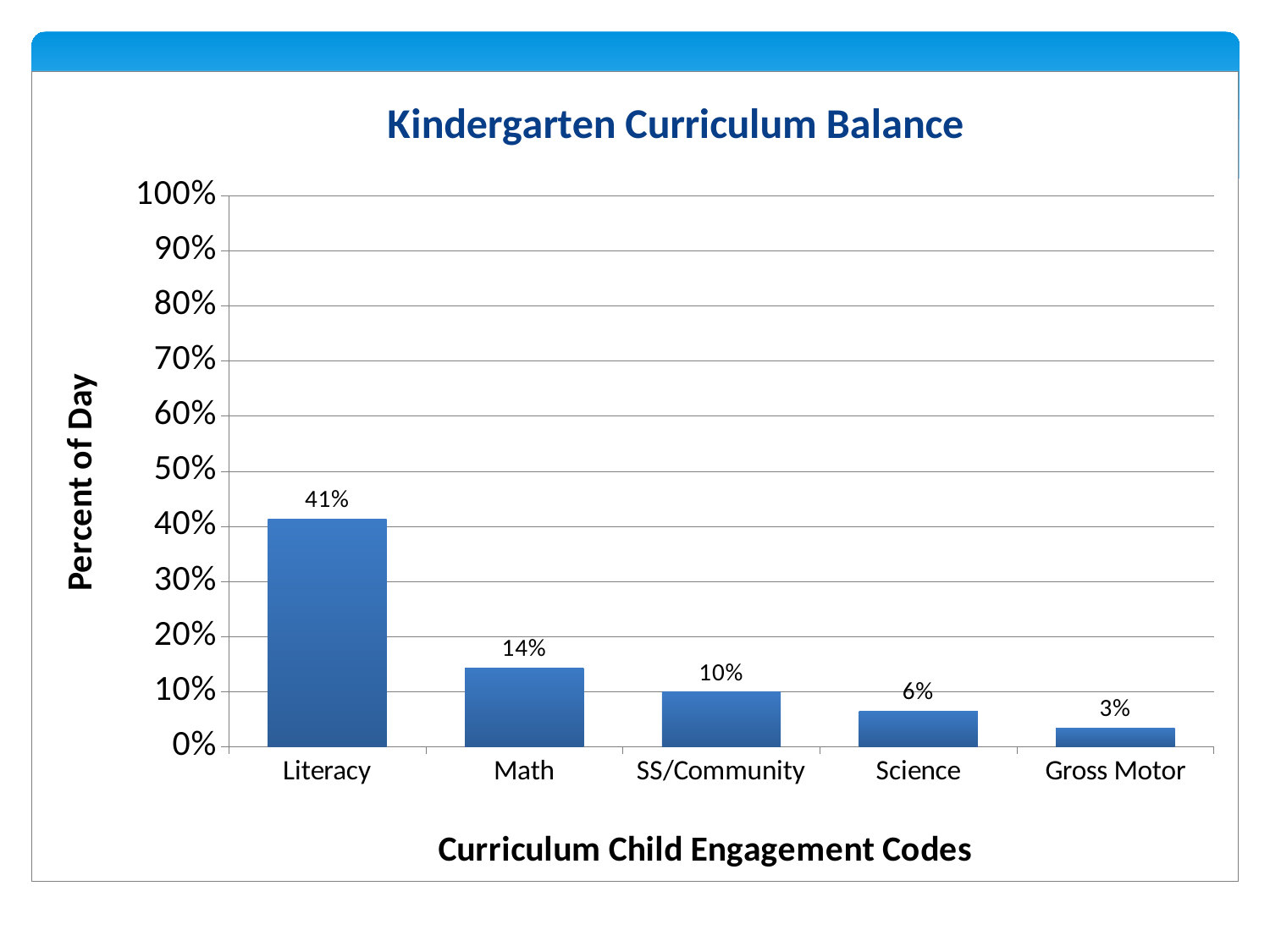
What is the value for Literacy? 41% What is the difference between the values for Literacy and Math? 27% What is the value for Math? 14% Which category has the highest percent of day? Literacy What is the value for Gross Motor? 3% What kind of chart is shown on the slide? bar chart Which is larger, the value for Math or the value for Science? Math What is the value for SS/Community? 10% How many categories are shown on the x axis? 5 What is the difference between the values for Science and Gross Motor? 3% Which category has the lowest percent of day? Gross Motor Is the value for Literacy greater or less than 50%? less